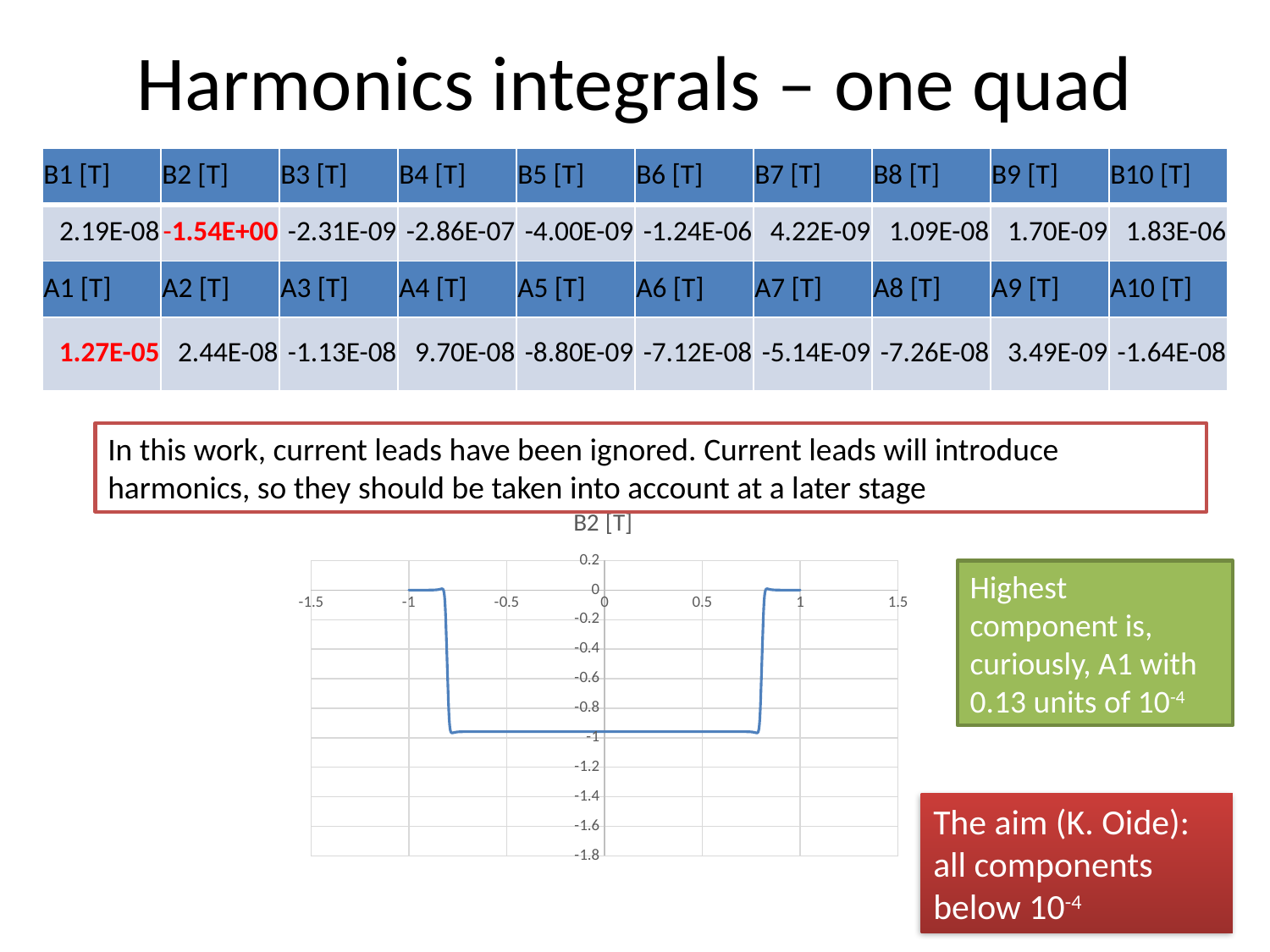
Is the value of the line at x = -0.5 greater or less than -1.4? greater Is the value of the line at x = 1 greater or less than -0.2? greater What kind of chart is shown on the slide? line chart Does the line rise or fall as x goes from -1 to -0.8? fall Is the value of the line at x = 0 greater or less than -0.8? less What is the lowest value shown on the chart's vertical axis? -1.8 What is the title of the chart? B2 [T] Does the line rise or fall as x goes from 0.8 to 1? rise